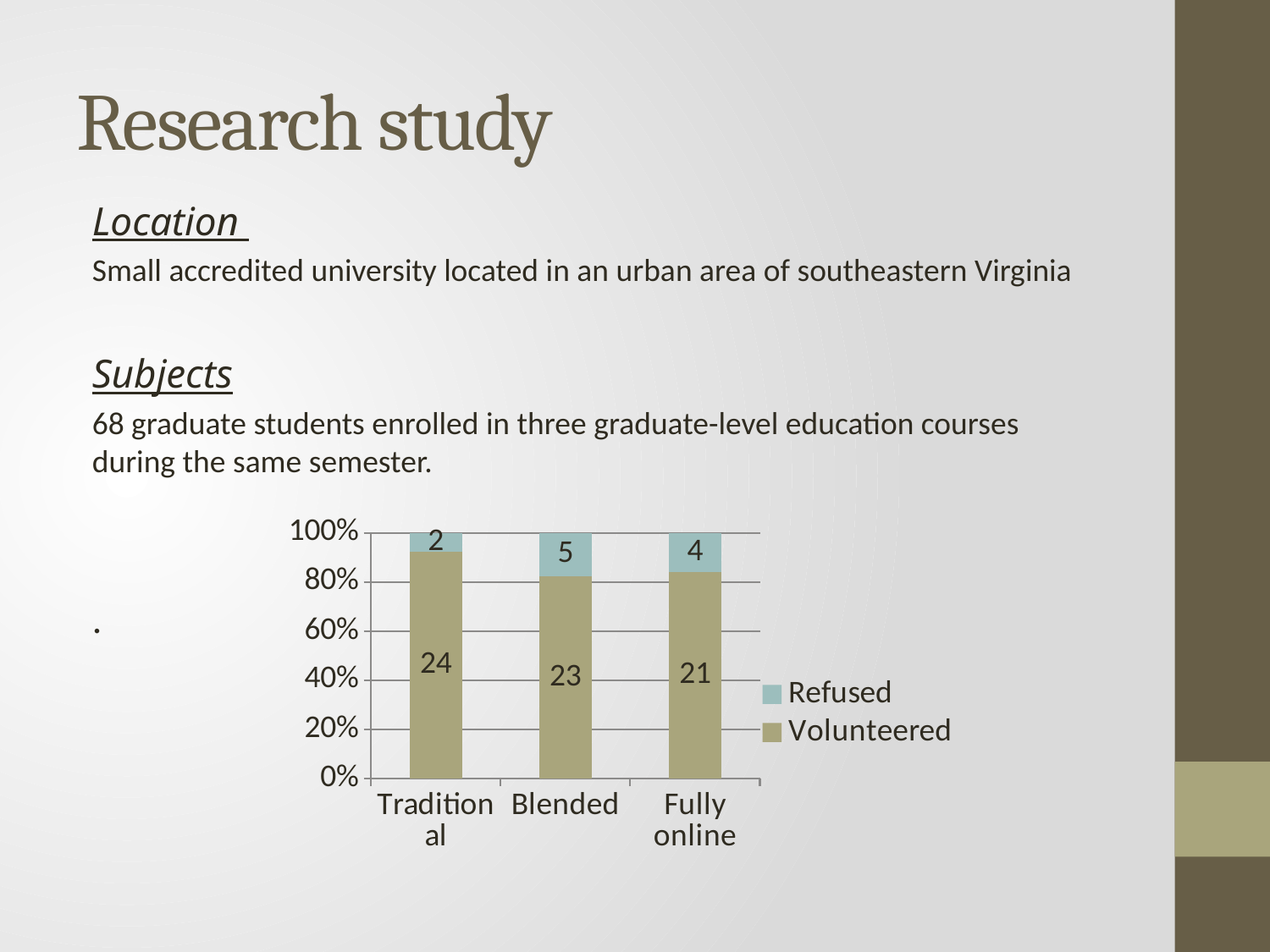
What is the Volunteered value for the Traditional course? 24 What is the Refused value for the Fully online course? 4 What is the Volunteered value for the Fully online course? 21 What is the Refused value for the Blended course? 5 What kind of chart is shown on the slide? Stacked bar chart Which is larger, the Refused value for Blended or the Refused value for Fully online? Blended How many courses are shown on the x axis of the chart? 3 What is the total of the Volunteered and Refused values for the Blended course? 28 How many series does the chart legend list? 2 Which course has the lowest Refused value? Traditional Which course has the highest Volunteered value? Traditional What is the difference between the Volunteered values for Traditional and Fully online? 3